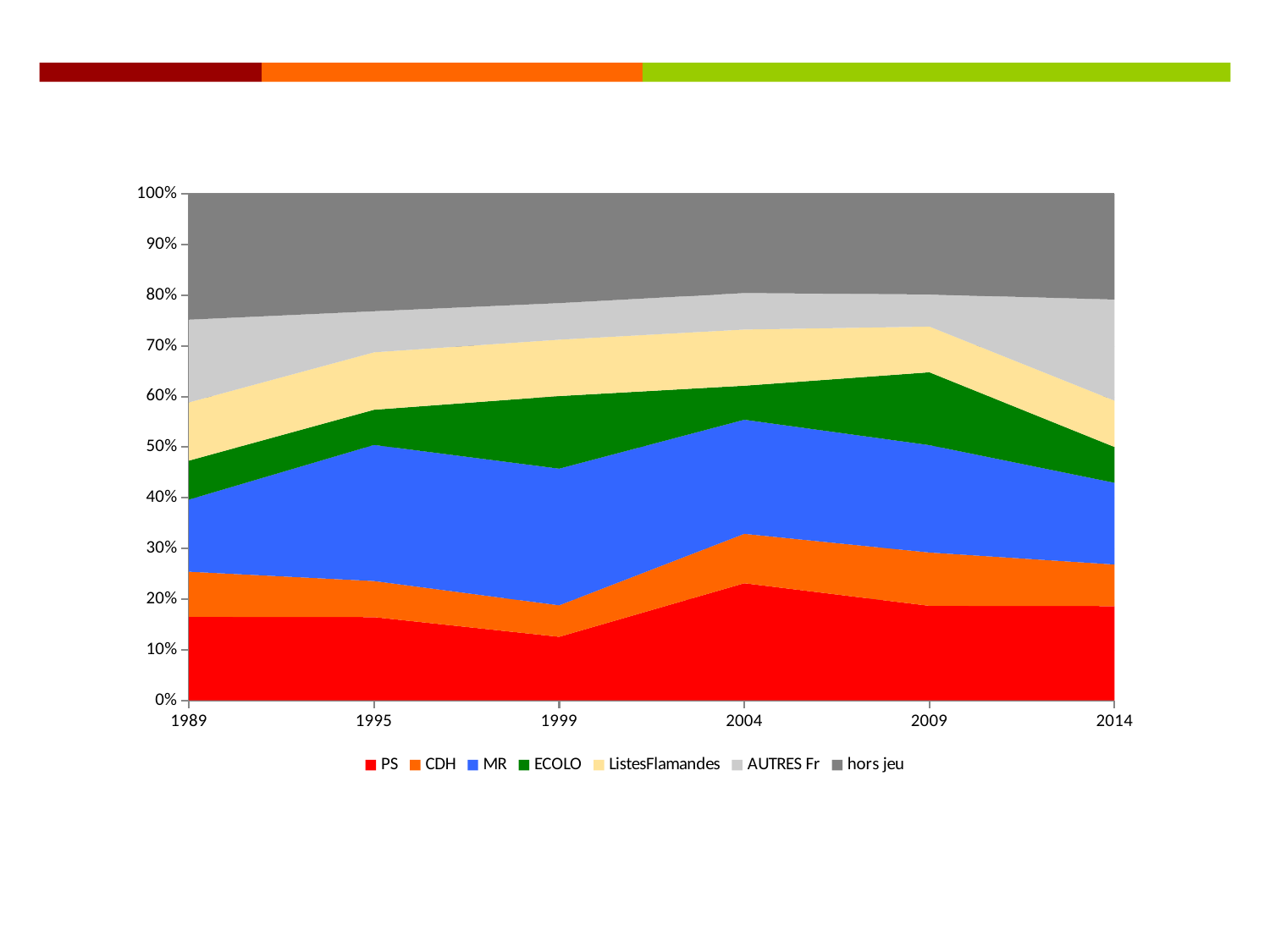
Is the PS share in 1999 greater or less than 15%? less Which series is plotted at the bottom of the stack? PS In which year is the PS share highest? 2004 Does the PS share rise or fall from 1995 to 1999? fall How many years are shown along the x axis? 6 Is the PS share in 2004 larger or smaller than in 1999? larger How many series does the legend list? 7 Is the 'hors jeu' share larger in 1989 or in 2004? 1989 Is the PS share in 2004 greater or less than 20%? greater What kind of chart is shown on the slide? area chart Which year is the first one shown on the x axis? 1989 In which year is the PS share lowest? 1999